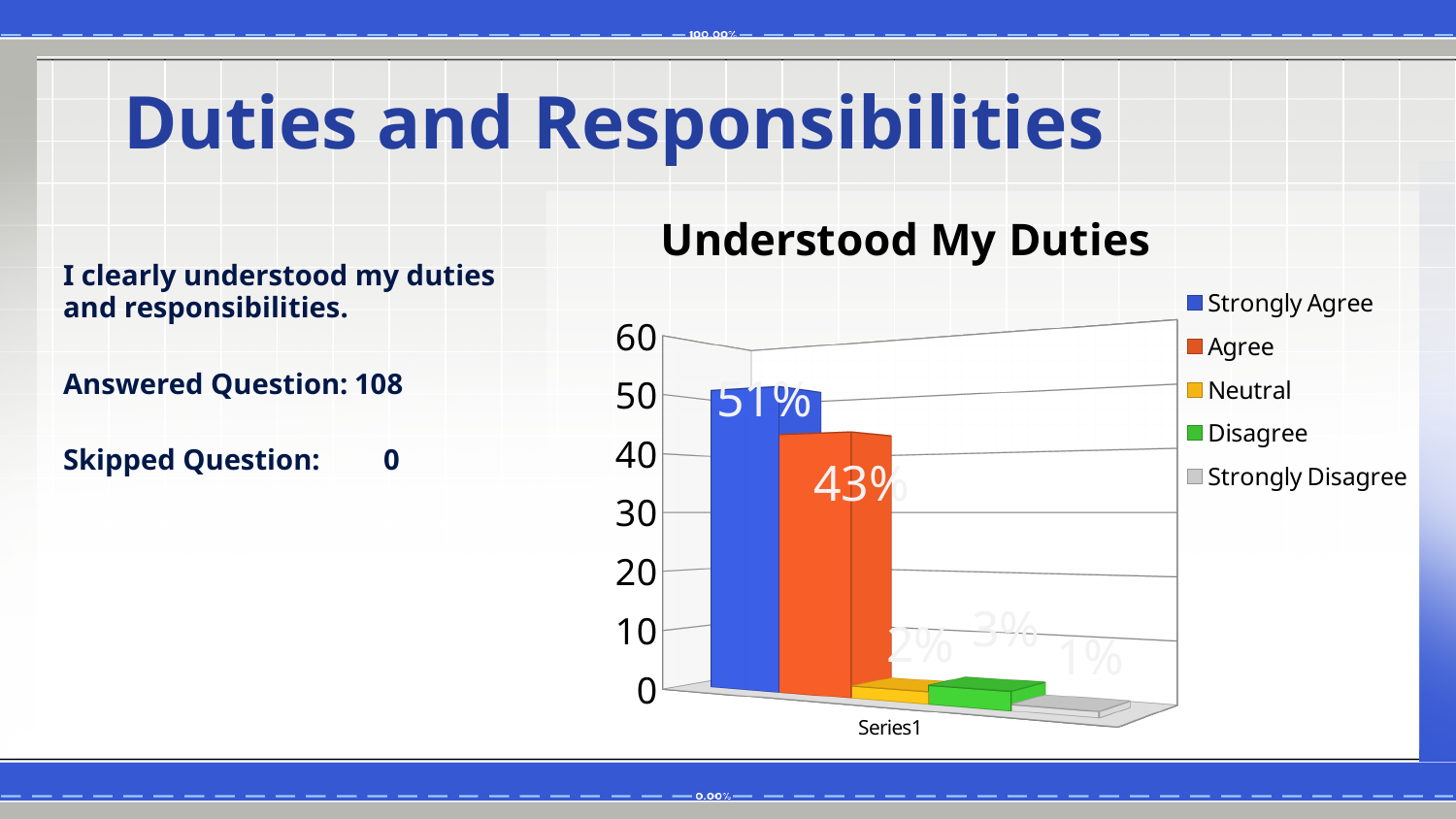
How many entries does the legend of the Understood My Duties chart list? 5 What kind of chart is the Understood My Duties chart? Bar chart What is the value for Disagree in the Understood My Duties chart? 3% Which response has the lowest value in the Understood My Duties chart? Strongly Disagree What is the difference between the Strongly Agree and Agree values in the Understood My Duties chart? 8% What is the value for Neutral in the Understood My Duties chart? 2% Which response has the highest value in the Understood My Duties chart? Strongly Agree What is the value for Agree in the Understood My Duties chart? 43% What is the value for Strongly Disagree in the Understood My Duties chart? 1% What is the value for Strongly Agree in the Understood My Duties chart? 51% Which is larger in the Understood My Duties chart, Neutral or Disagree? Disagree Is the value for Agree in the Understood My Duties chart greater or less than 40? greater